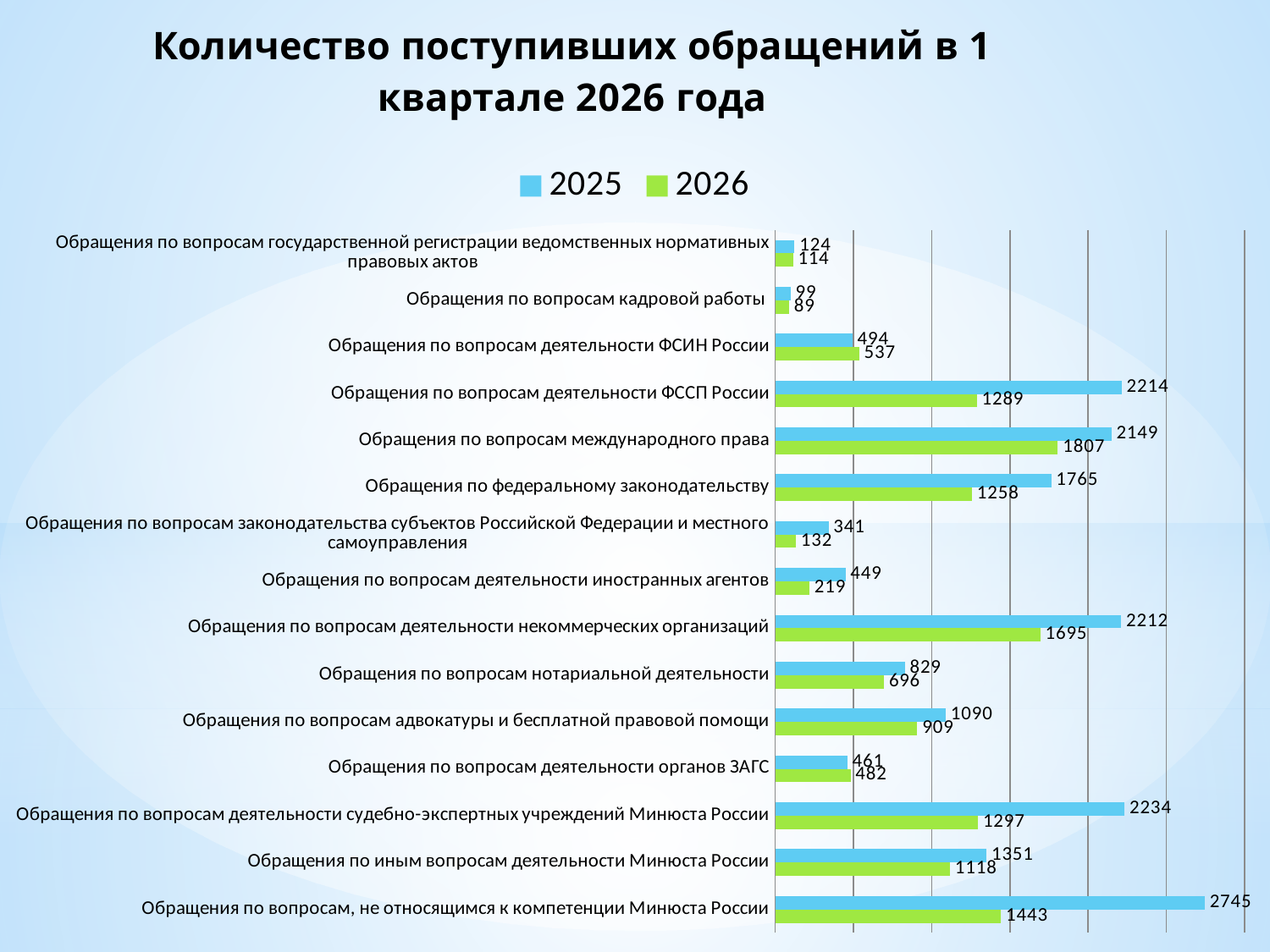
Which category has the highest 2026 value? Обращения по вопросам международного права For "Обращения по вопросам деятельности органов ЗАГС", which year has the larger value, 2025 or 2026? 2026 What is the 2025 value for "Обращения по вопросам деятельности ФССП России"? 2214 What kind of chart is shown on the slide? Bar chart Which category has the highest 2025 value? Обращения по вопросам, не относящимся к компетенции Минюста России How many categories are plotted on the chart? 15 What is the 2026 value for "Обращения по вопросам международного права"? 1807 Which colour represents the 2026 series in the legend? Green Which category has the lowest 2026 value? Обращения по вопросам кадровой работы What is the 2026 value for "Обращения по вопросам деятельности иностранных агентов"? 219 How many series does the legend list? 2 What is the difference between the 2025 and 2026 values for "Обращения по вопросам деятельности судебно-экспертных учреждений Минюста России"? 937